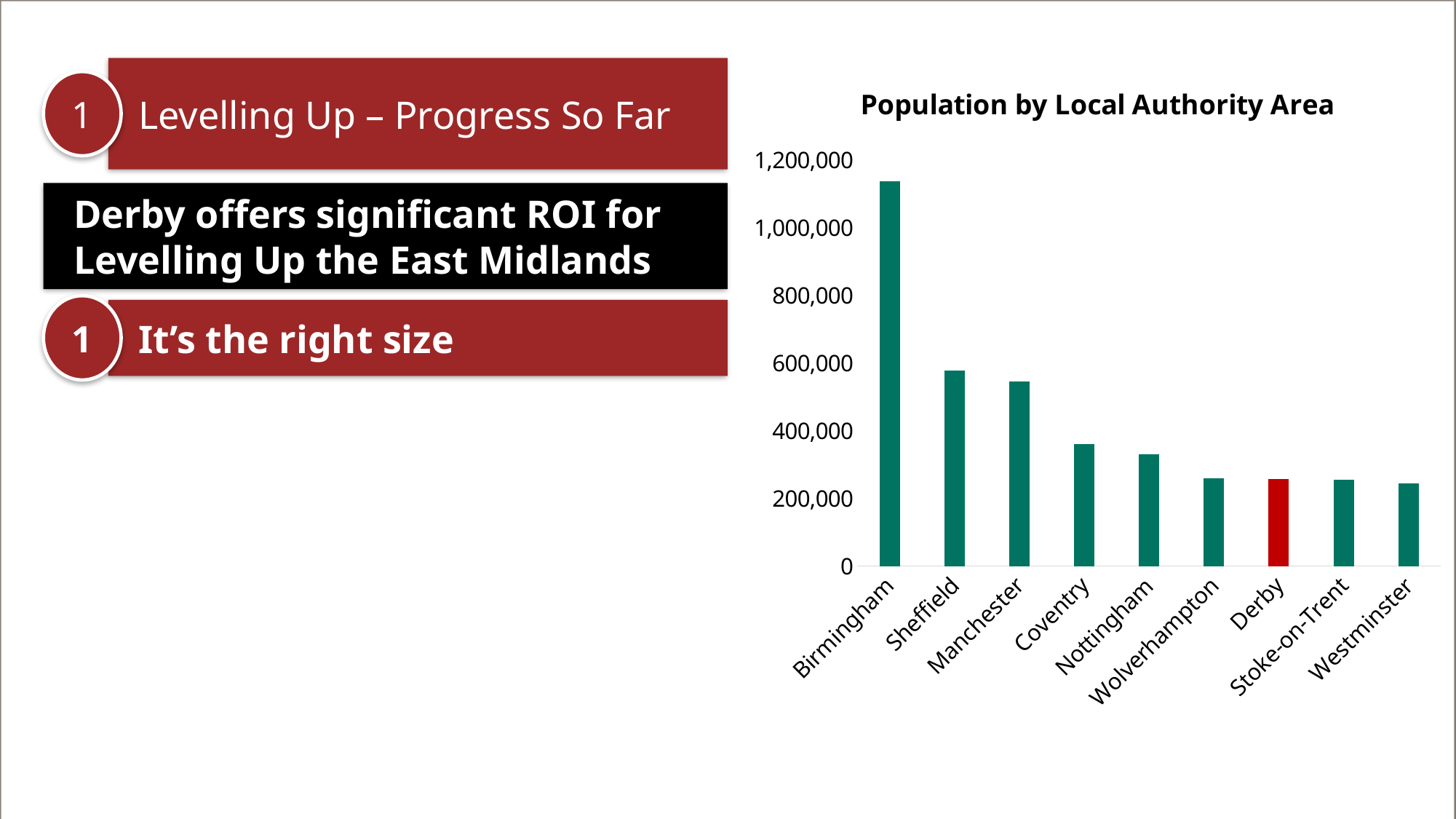
How many local authority areas are shown in the chart? 9 Which local authority area's bar is coloured red rather than green? Derby Which has the larger population, Sheffield or Manchester? Sheffield Is the value for Manchester greater or less than 400,000? greater Is the value for Birmingham greater or less than 1,000,000? greater Is the value for Derby greater or less than 200,000? greater What is the title of the chart? Population by Local Authority Area Which local authority area has the highest population in the chart? Birmingham Do the values generally rise or fall moving from left to right along the x axis? fall What kind of chart is shown on the slide? bar chart